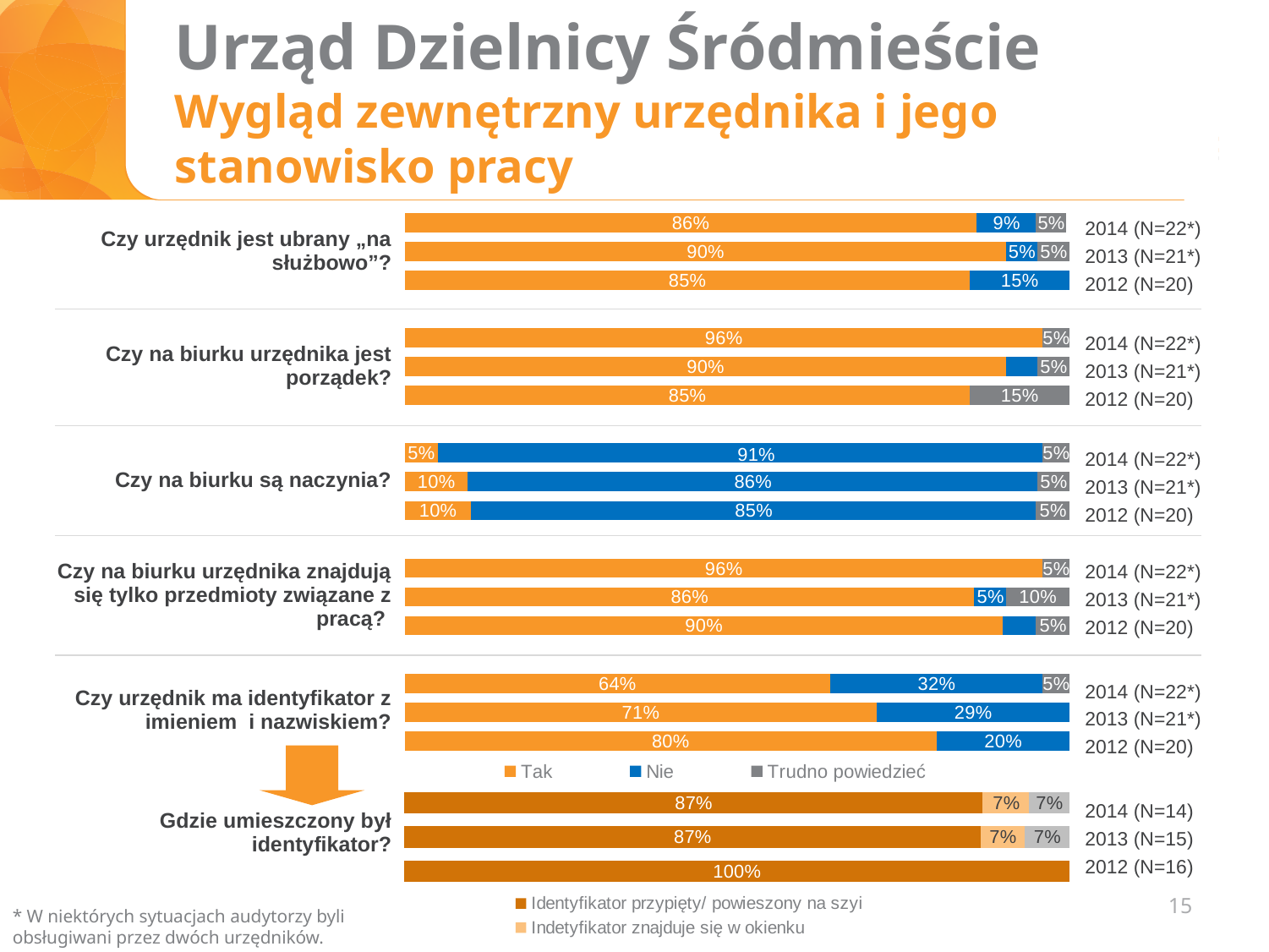
What type of chart is used on this slide? Stacked bar chart In the chart for "Gdzie umieszczony był identyfikator?", what percentage had the badge pinned/hung on the neck ("Identyfikator przypięty/ powieszony na szyi") in 2012 (N=16)? 100% In the chart for "Czy urzędnik ma identyfikator z imieniem i nazwiskiem?", does the "Tak" share rise or fall from 2012 to 2014? fall In the chart for "Czy na biurku urzędnika znajdują się tylko przedmioty związane z pracą?", what is the "Trudno powiedzieć" share in 2013 (N=21*)? 10% In the chart for "Czy urzędnik ma identyfikator z imieniem i nazwiskiem?", which year has the lowest "Tak" share? 2014 (N=22*) In the chart for "Czy na biurku urzędnika jest porządek?", which year has the highest "Tak" share? 2014 (N=22*) How many series does the legend with "Tak", "Nie" and "Trudno powiedzieć" list? 3 In the chart for "Czy urzędnik jest ubrany „na służbowo”?", what percentage answered "Nie" in 2012 (N=20)? 15% In the chart for "Czy na biurku są naczynia?", what is the "Tak" share in 2013 (N=21*)? 10% In the chart for "Czy urzędnik jest ubrany „na służbowo”?", what percentage answered "Tak" in 2014 (N=22*)? 86% In the chart for "Czy urzędnik ma identyfikator z imieniem i nazwiskiem?", what is the difference between the "Tak" share in 2012 (N=20) and in 2014 (N=22*)? 16% In the chart for "Czy na biurku są naczynia?", what percentage answered "Nie" in 2014 (N=22*)? 91%